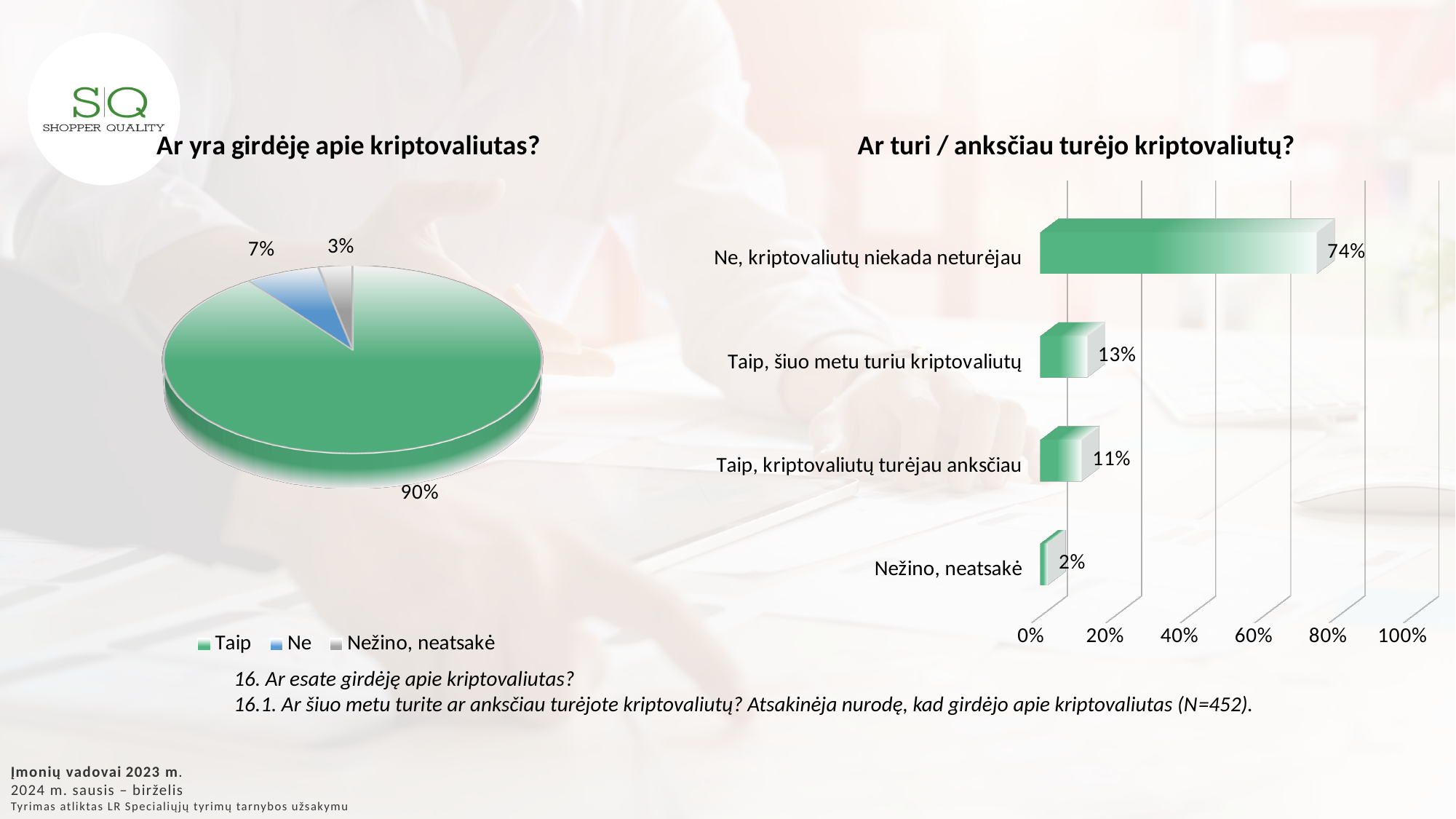
In the bar chart 'Ar turi / anksčiau turėjo kriptovaliutų?', which category has the lowest value? Nežino, neatsakė In the pie chart 'Ar yra girdėję apie kriptovaliutas?', what is the difference between the 'Taip' and 'Ne' shares? 83% In the bar chart 'Ar turi / anksčiau turėjo kriptovaliutų?', what is the value for 'Taip, šiuo metu turiu kriptovaliutų'? 13% What kind of chart is the chart on the right of the slide? Bar chart In the pie chart 'Ar yra girdėję apie kriptovaliutas?', what share of respondents answered 'Taip'? 90% In the pie chart 'Ar yra girdėję apie kriptovaliutas?', what is the value for 'Nežino, neatsakė'? 3% In the bar chart 'Ar turi / anksčiau turėjo kriptovaliutų?', how many categories are shown? 4 In the bar chart 'Ar turi / anksčiau turėjo kriptovaliutų?', what is the value for 'Ne, kriptovaliutų niekada neturėjau'? 74% What kind of chart is the chart on the left of the slide? Pie chart In the pie chart 'Ar yra girdėję apie kriptovaliutas?', what is the value for 'Ne'? 7% In the pie chart 'Ar yra girdėję apie kriptovaliutas?', how many slices does the pie have? 3 In the bar chart 'Ar turi / anksčiau turėjo kriptovaliutų?', what is the difference between 'Taip, šiuo metu turiu kriptovaliutų' and 'Taip, kriptovaliutų turėjau anksčiau'? 2%